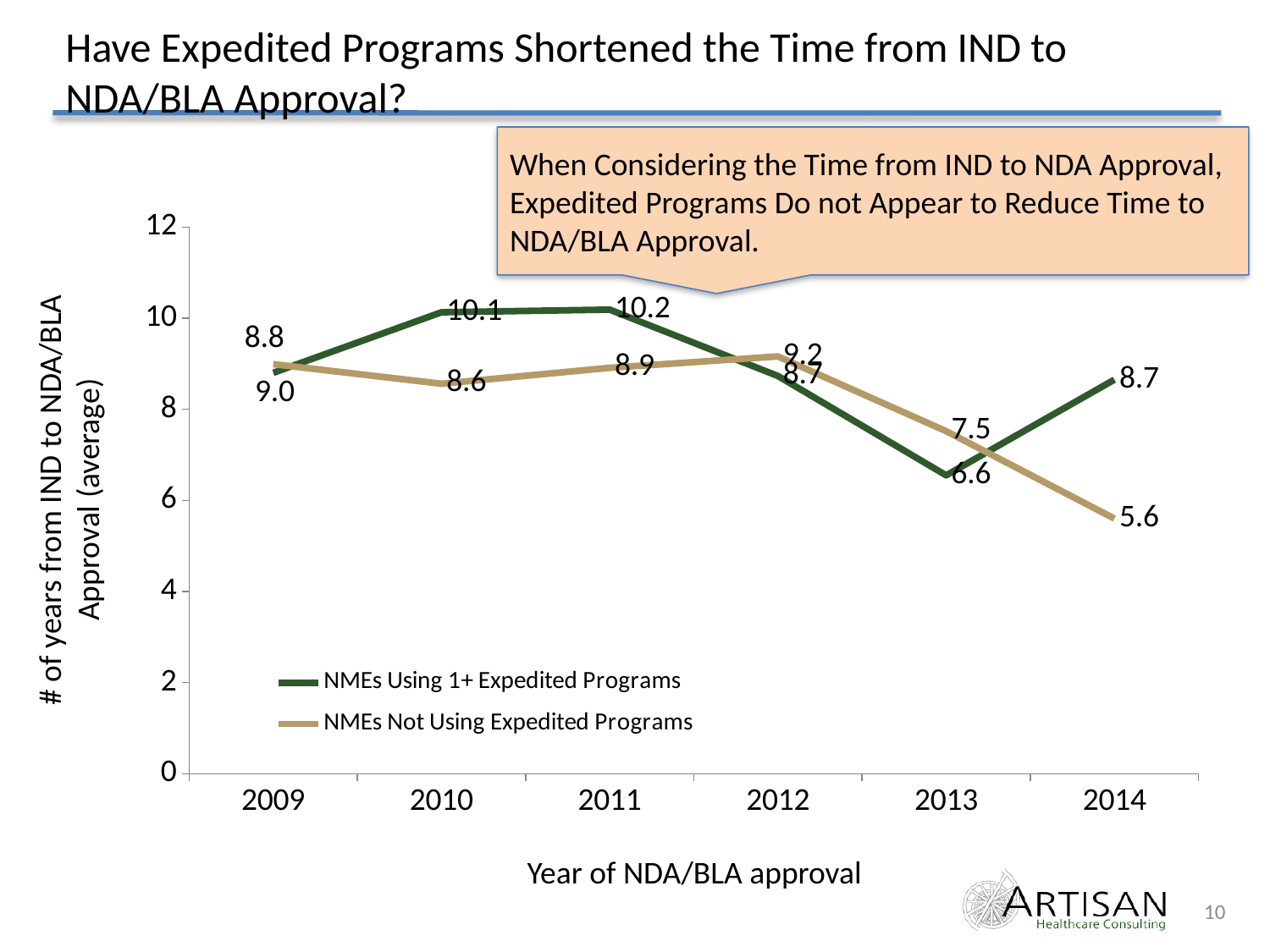
What is the difference between the two series in 2014? 3.1 What is the value for NMEs Using 1+ Expedited Programs in 2013? 6.6 Does the value for NMEs Not Using Expedited Programs rise or fall from 2012 to 2014? fall How many years are shown on the x axis? 6 Which series has the larger value in 2010? NMEs Using 1+ Expedited Programs In which year is the value for NMEs Not Using Expedited Programs lowest? 2014 What is the value for NMEs Using 1+ Expedited Programs in 2011? 10.2 What is the label of the y axis? # of years from IND to NDA/BLA Approval (average) In which year is the value for NMEs Using 1+ Expedited Programs highest? 2011 How many series does the legend list? 2 What is the value for NMEs Not Using Expedited Programs in 2014? 5.6 What type of chart is shown on the slide? line chart